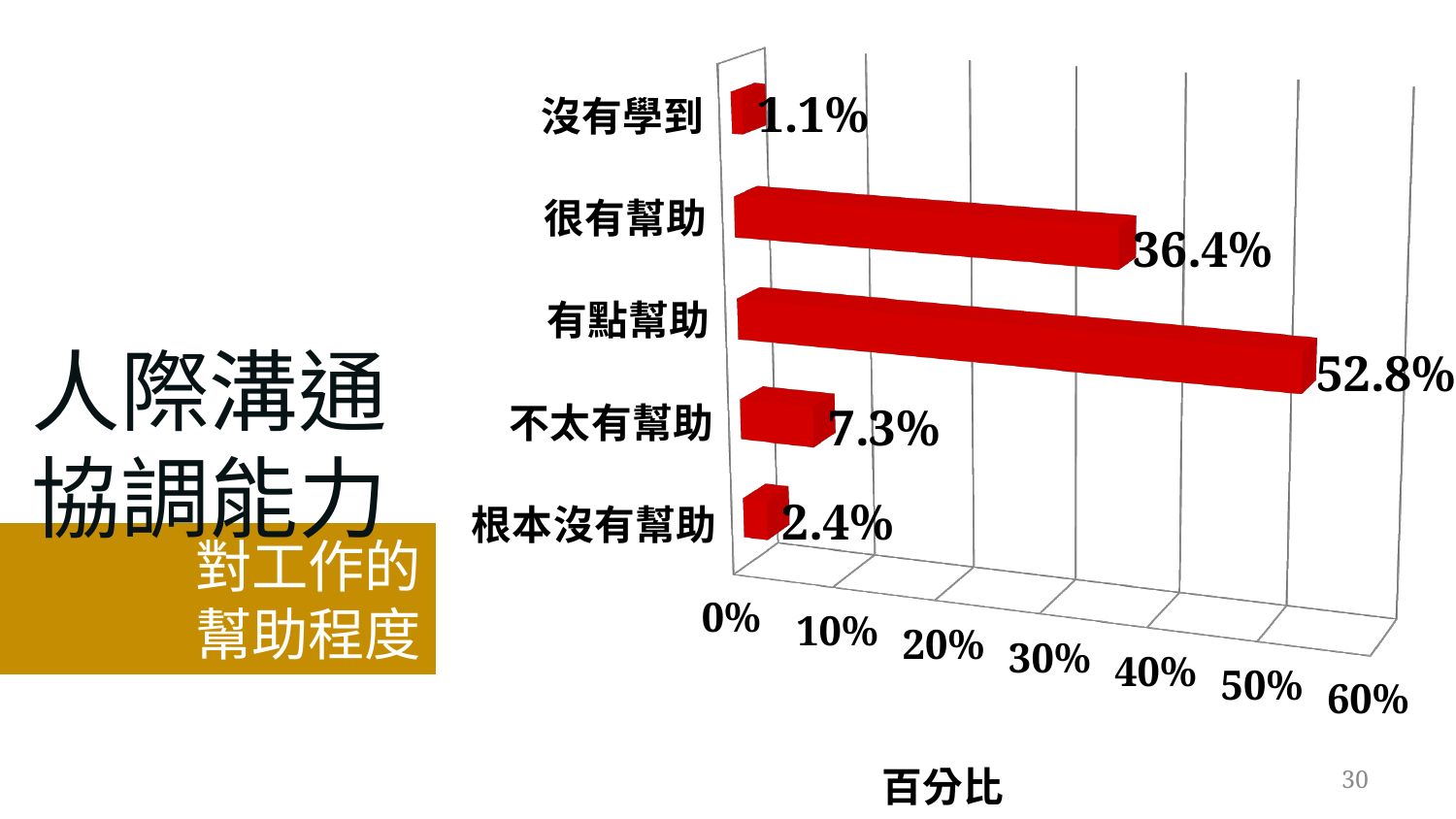
What is the value for 有點幫助? 52.8% What is the label of the horizontal axis? 百分比 What is the value for 根本沒有幫助? 2.4% Which is larger, the value for 不太有幫助 or the value for 根本沒有幫助? 不太有幫助 What is the value for 沒有學到? 1.1% Which category has the lowest value? 沒有學到 How many categories are shown in the chart? 5 Which category has the highest value? 有點幫助 What is the value for 不太有幫助? 7.3% What is the value for 很有幫助? 36.4% What kind of chart is shown on the slide? bar chart What is the difference between the values for 有點幫助 and 很有幫助? 16.4%